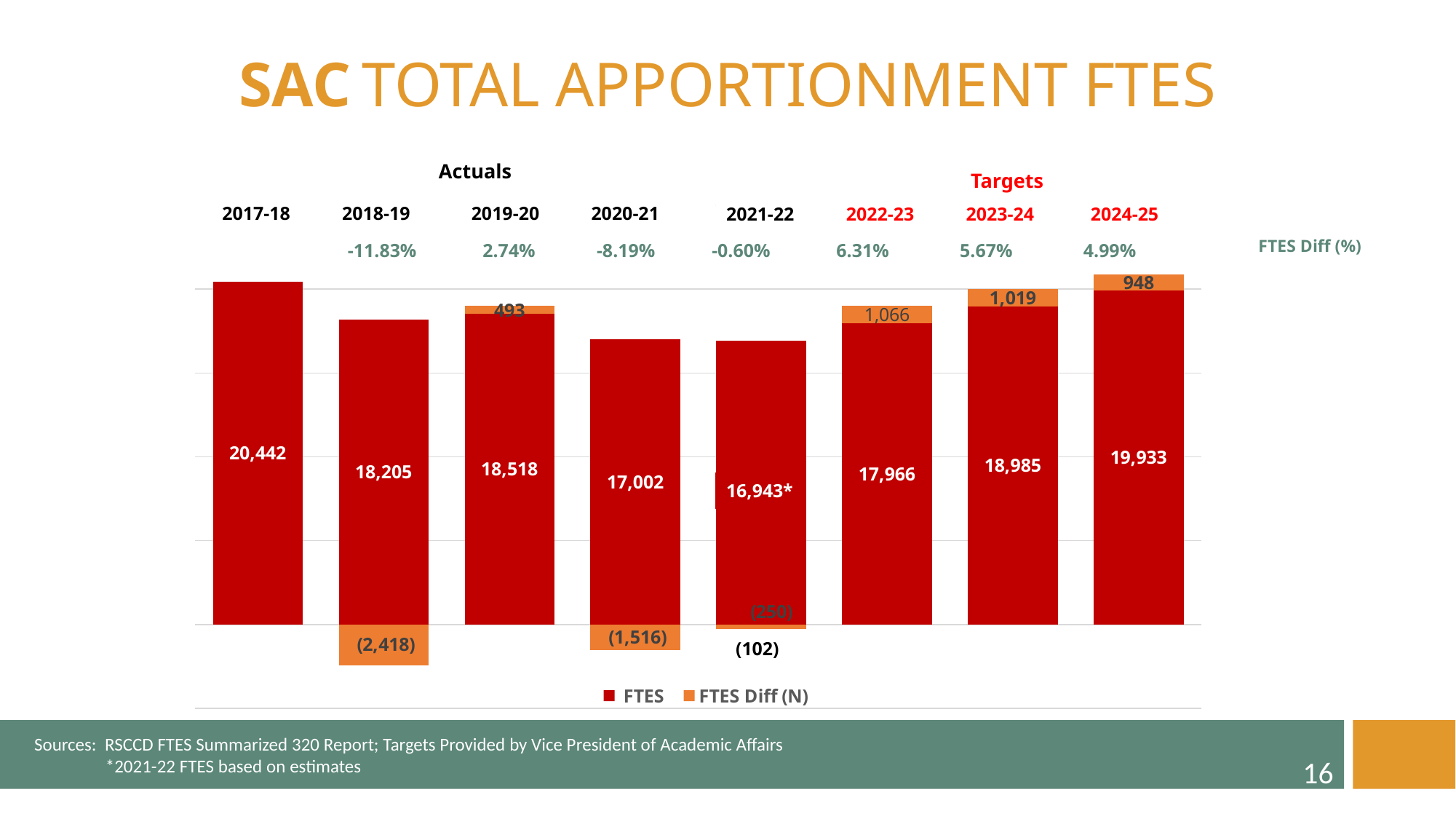
What is the FTES Diff (%) shown for 2020-21? -8.19% Which is larger, the FTES value for 2019-20 or for 2020-21? 2019-20 What is the FTES Diff (N) value for 2022-23? 1,066 What is the FTES value for 2023-24? 18,985 What type of chart is shown on the slide? Bar chart What is the FTES value for 2017-18? 20,442 How many years are shown on the x axis of the chart? 8 Which year has the highest FTES value? 2017-18 How many series does the chart legend list? 2 Which year has the lowest FTES value? 2021-22 What is the difference between the FTES values for 2017-18 and 2018-19? 2,237 What is the FTES Diff (N) value for 2018-19? (2,418)